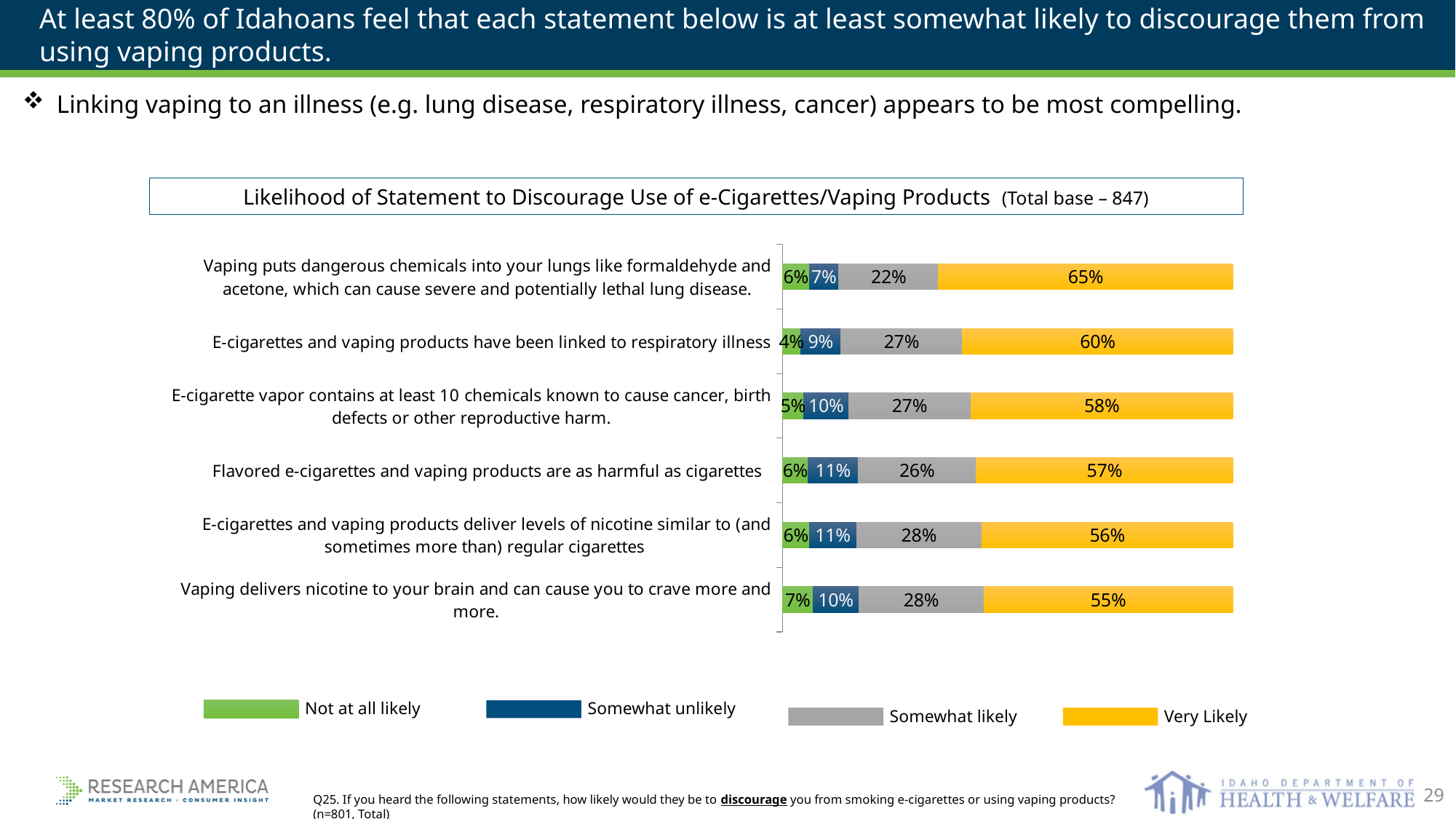
What is the 'Somewhat likely' value for 'E-cigarettes and vaping products have been linked to respiratory illness'? 27% What is the 'Not at all likely' value for 'Vaping delivers nicotine to your brain and can cause you to crave more and more'? 7% Which statement has the highest 'Very Likely' value? Vaping puts dangerous chemicals into your lungs like formaldehyde and acetone, which can cause severe and potentially lethal lung disease. What is the difference between the 'Very Likely' values for the 'dangerous chemicals into your lungs' statement and the 'linked to respiratory illness' statement? 5% Which statement has the lowest 'Very Likely' value? Vaping delivers nicotine to your brain and can cause you to crave more and more. What is the total base shown in the chart title? 847 Which is larger: the 'Somewhat likely' value for 'E-cigarette vapor contains at least 10 chemicals known to cause cancer' or for 'Vaping puts dangerous chemicals into your lungs'? E-cigarette vapor contains at least 10 chemicals known to cause cancer, birth defects or other reproductive harm. What kind of chart is shown on the slide? Stacked bar chart How many statements (categories) are plotted in the chart? 6 How many series does the legend list? 4 What is the 'Very Likely' value for the statement 'Vaping puts dangerous chemicals into your lungs like formaldehyde and acetone'? 65% What is the 'Somewhat unlikely' value for 'Flavored e-cigarettes and vaping products are as harmful as cigarettes'? 11%